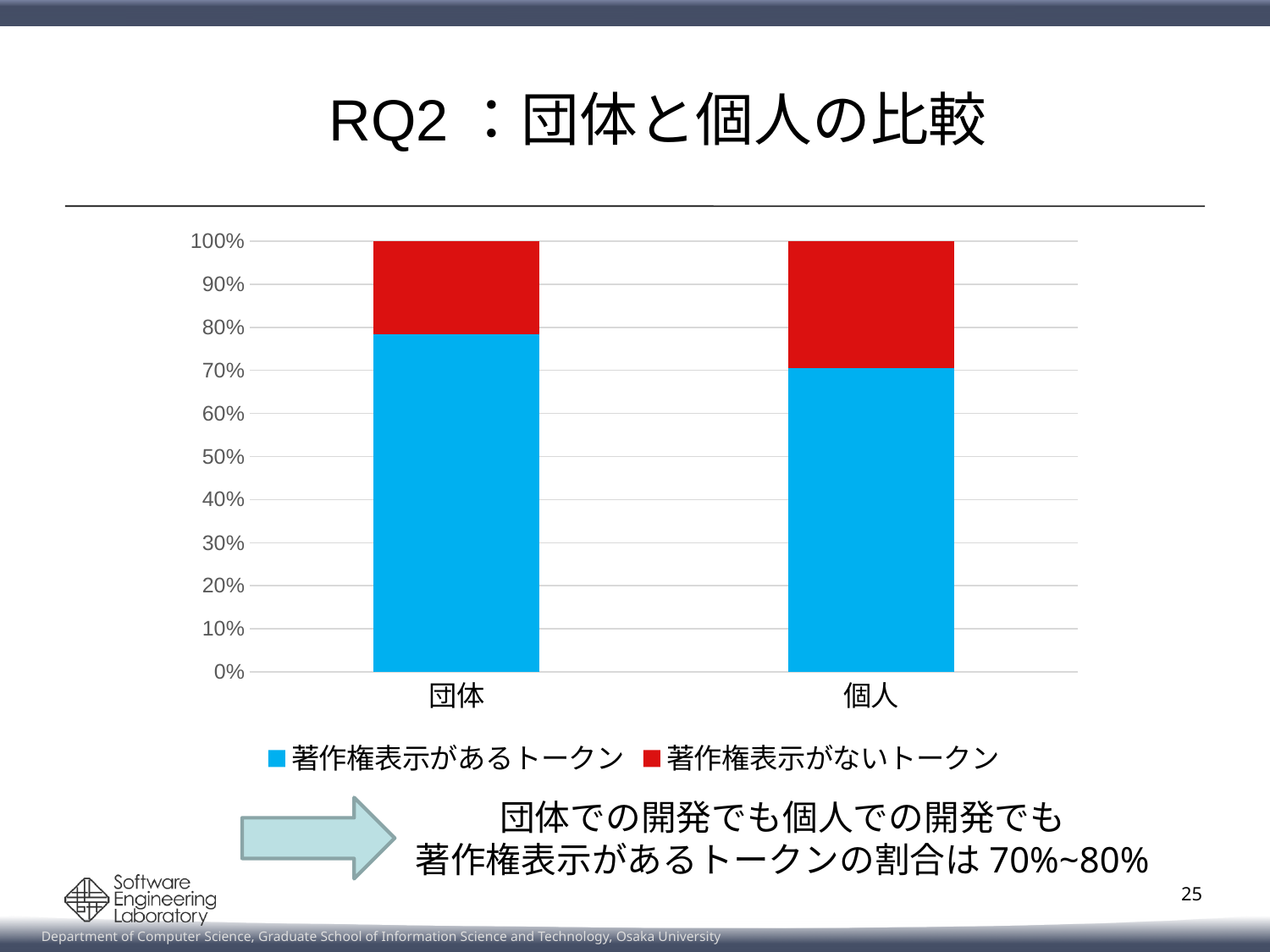
How many series does the chart's legend list? 2 How many categories are shown on the x axis of the chart? 2 Is the value for 著作権表示があるトークン in the 団体 bar greater or less than 70%? greater Which category has the larger share of 著作権表示があるトークン, 団体 or 個人? 団体 What is the title of the slide containing the chart? RQ2：団体と個人の比較 Is the value for 著作権表示があるトークン in the 個人 bar greater or less than 80%? less Which colour represents 著作権表示がないトークン in the chart? red Is the value for 著作権表示があるトークン in the 団体 bar greater or less than 80%? less What is the total height of the stacked bar for 団体? 100% Which category has the larger share of 著作権表示がないトークン, 団体 or 個人? 個人 What kind of chart is shown on the slide? bar chart